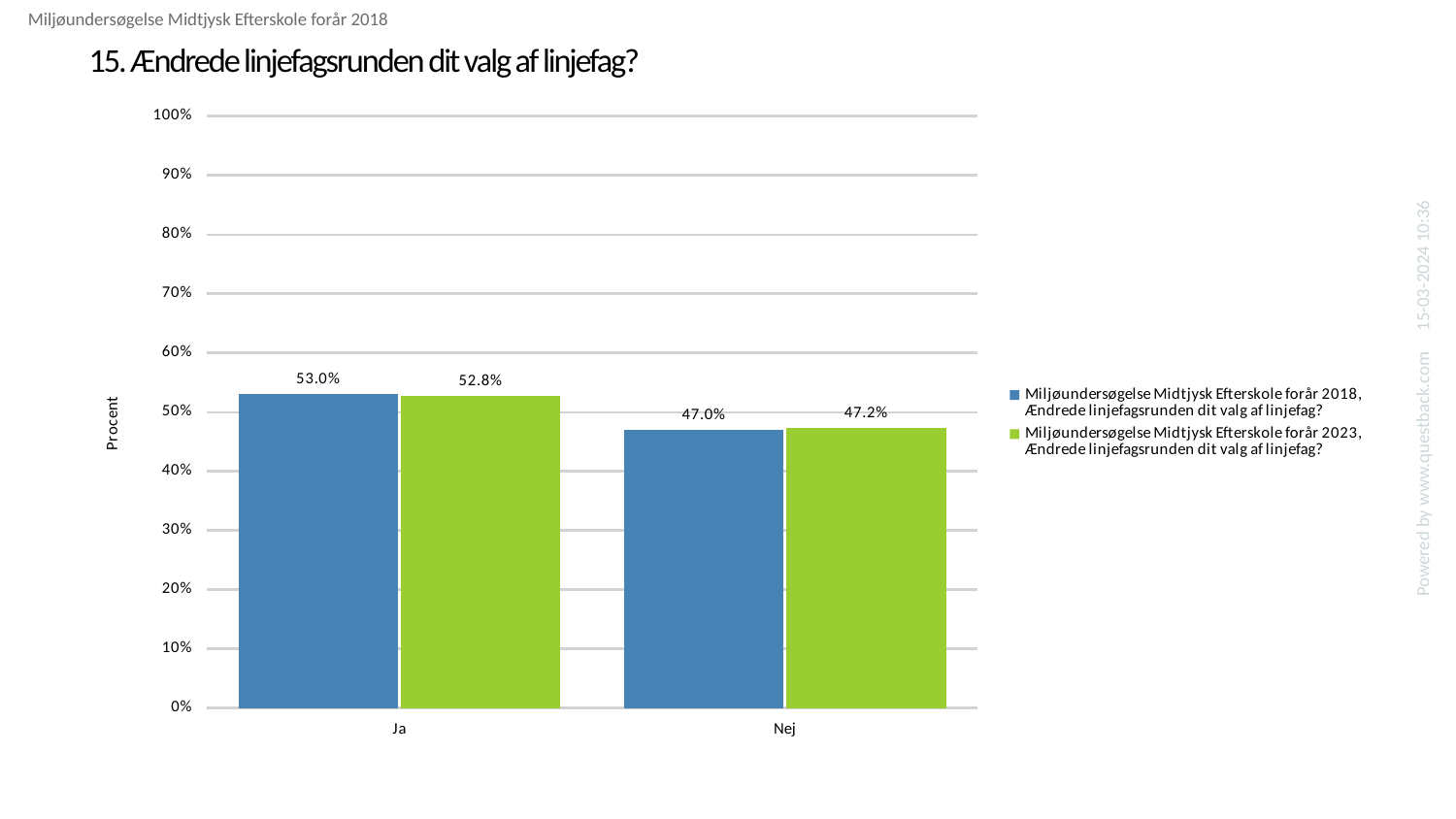
How many series does the legend list? 2 Which category has the lowest value in the 2023 series? Nej How many categories are shown on the x axis? 2 What kind of chart is shown on the slide? Bar chart Which category has the highest value in the 2018 series? Ja What is the value for "Nej" in the 2018 series? 47.0% What is the value for "Ja" in the 2023 series? 52.8% What is the difference between the 2018 values for "Ja" and "Nej"? 6.0% What is the value for "Nej" in the 2023 series? 47.2% In the 2023 series, which is larger: the value for "Ja" or the value for "Nej"? Ja Is the 2018 value for "Nej" greater or less than 50%? less What is the value for "Ja" in the 2018 series? 53.0%